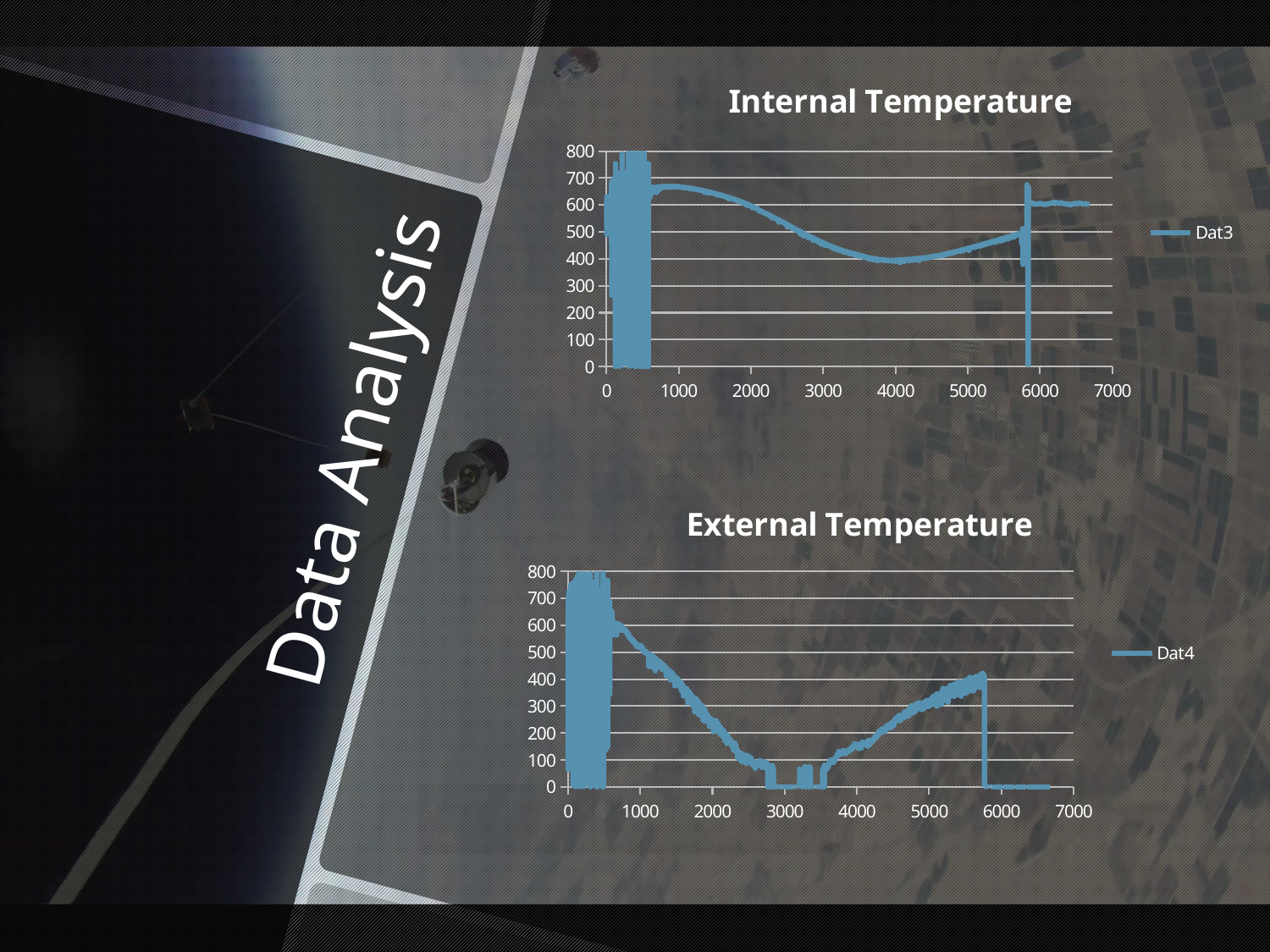
How many series does the legend of the External Temperature chart list? 1 What is the name of the series shown in the legend of the Internal Temperature chart? Dat3 In the External Temperature chart, is the value of Dat4 at x = 6000 greater or less than 100? less In the External Temperature chart, is the value of Dat4 at x = 3000 greater or less than 100? less How many series does the legend of the Internal Temperature chart list? 1 In the Internal Temperature chart, is the value of Dat3 at x = 1000 greater or less than 600? greater In the Internal Temperature chart, does Dat3 rise or fall between x = 1000 and x = 4000? fall What kind of chart is the External Temperature chart? line chart What kind of chart is the Internal Temperature chart? line chart In the External Temperature chart, does Dat4 rise or fall between x = 3500 and x = 5500? rise What is the name of the series shown in the legend of the External Temperature chart? Dat4